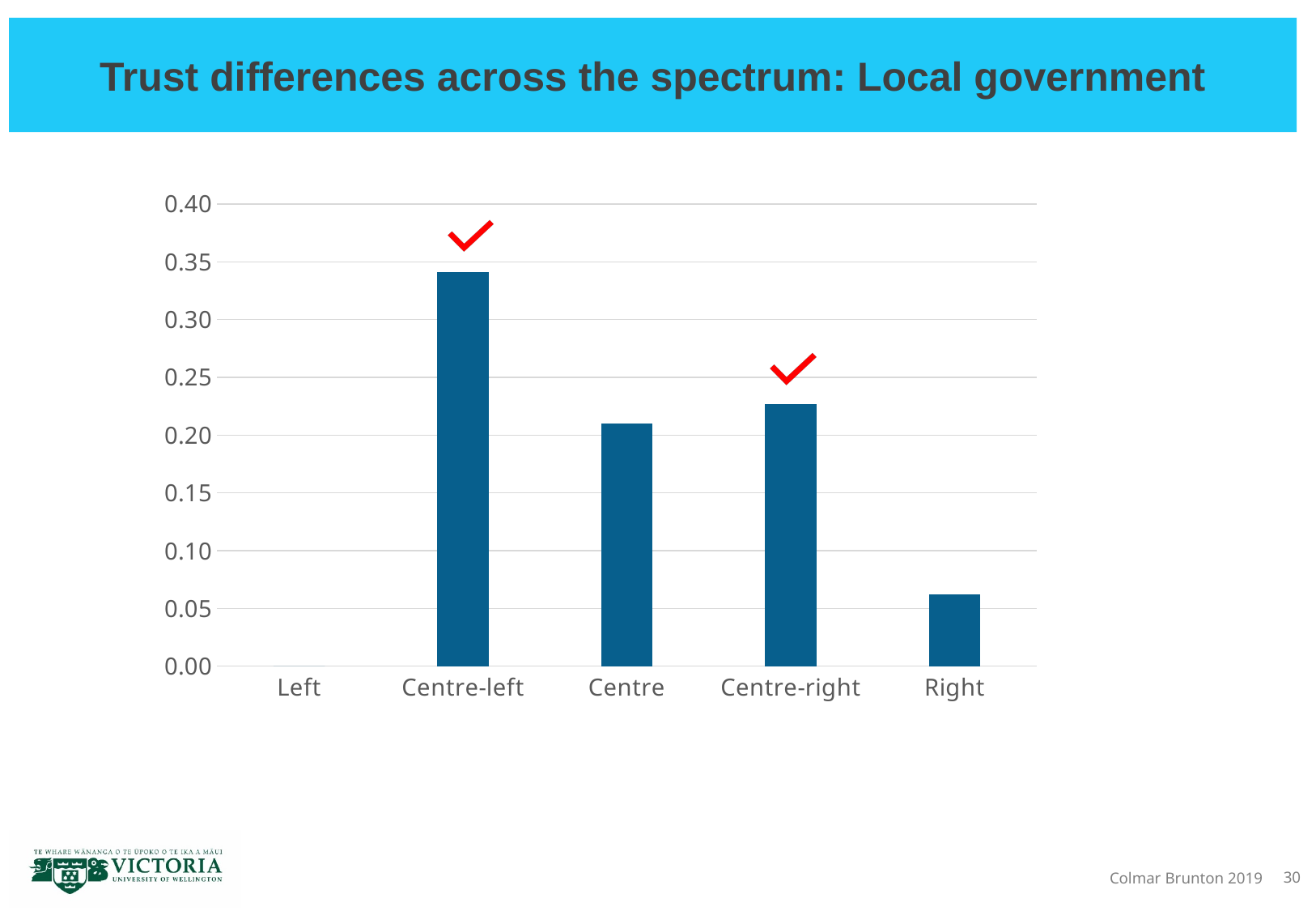
How many categories are shown on the x axis of the chart? 5 Is the value for Centre-left greater or less than 0.30? greater Which two categories have a red check mark above their bars? Centre-left and Centre-right Which has the larger value, Centre-left or Right? Centre-left Which has the larger value, Centre or Right? Centre Is the value for Centre less than or greater than 0.25? less Is the value for Right greater or less than 0.10? less Which category has the highest value in the chart? Centre-left What kind of chart is shown on the slide? bar chart Which category has the lowest value in the chart? Left